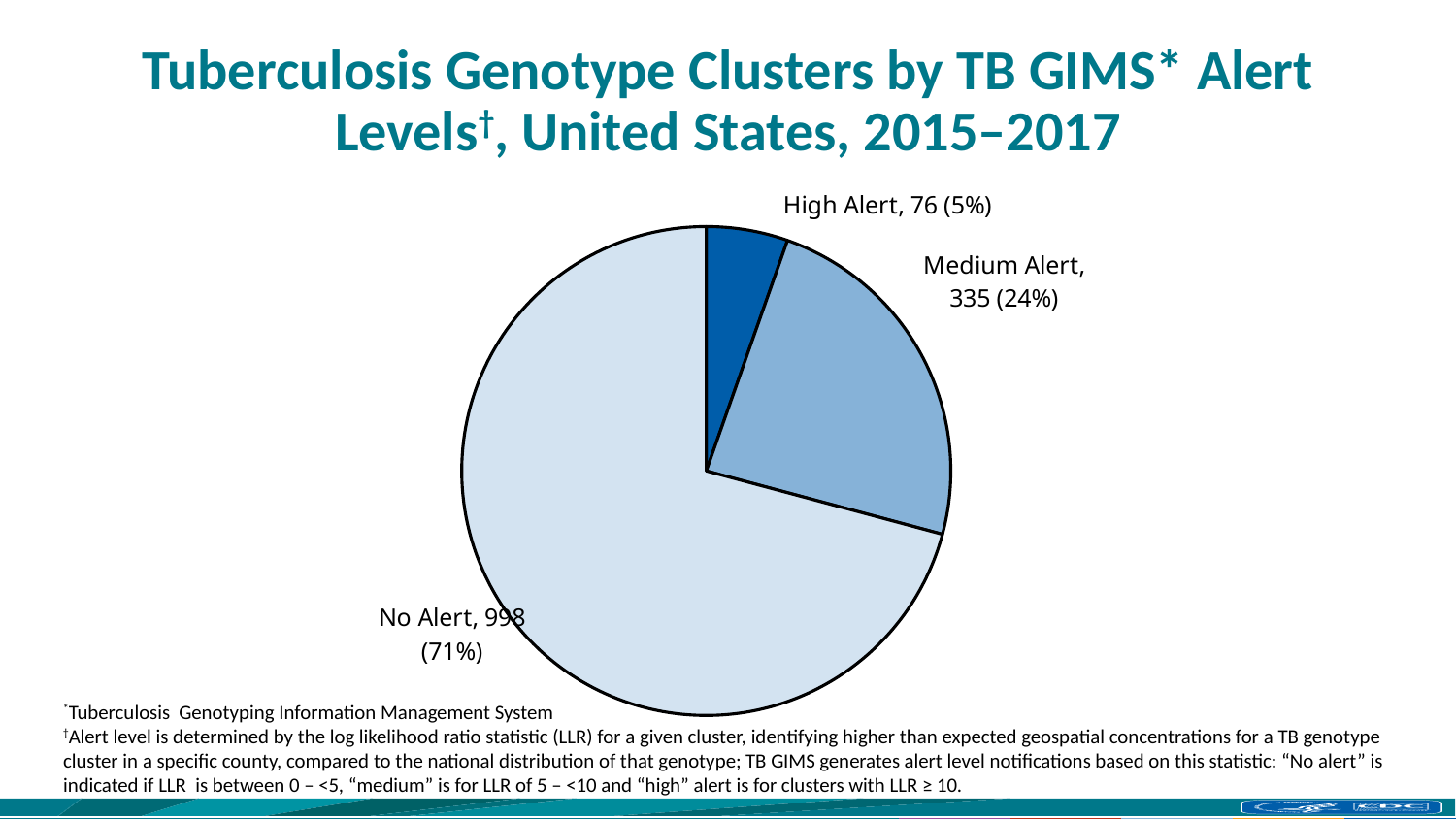
How many clusters are in the No Alert category? 998 What share of the pie does the High Alert slice represent? 5% Which alert level has the largest number of clusters? No Alert How many clusters are in the High Alert category? 76 What share of the pie does the Medium Alert slice represent? 24% Which has more clusters, Medium Alert or High Alert? Medium Alert What share of the pie does the No Alert slice represent? 71% What is the difference in cluster counts between Medium Alert and High Alert? 259 How many alert-level categories does the pie chart show? 3 What kind of chart is shown on the slide? pie chart Which alert level has the smallest number of clusters? High Alert How many clusters are in the Medium Alert category? 335